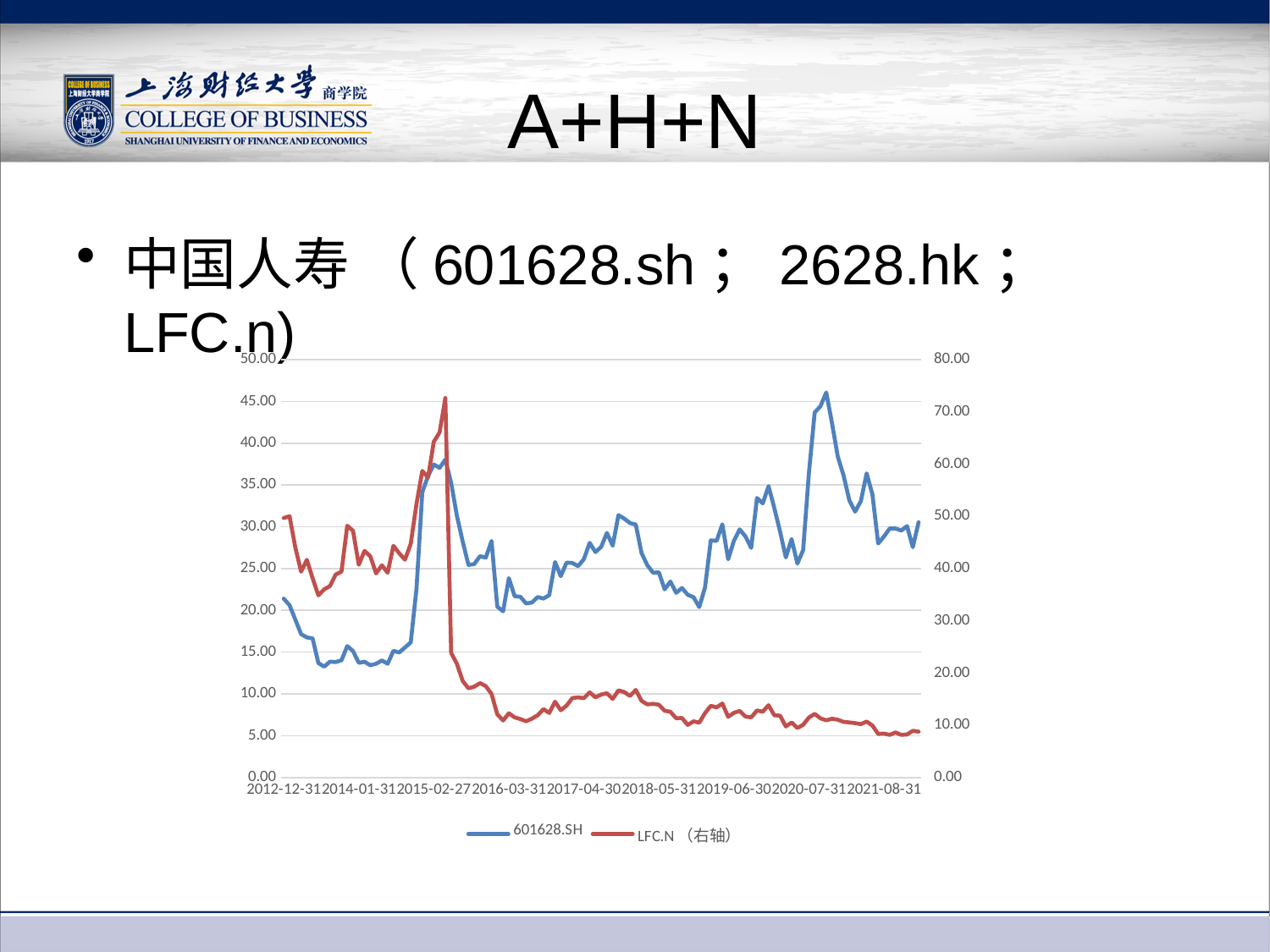
How many series does the chart's legend list? 2 Is the value of LFC.N at 2021-08-31 greater or less than 10 on the right axis? less Which series is plotted on the right axis according to the legend? LFC.N Does the 601628.SH series rise or fall from 2012-12-31 to 2014-01-31? fall Is the peak value of LFC.N around 2015 greater or less than 60 on the right axis? greater Does the LFC.N series rise or fall overall from 2016-03-31 to 2021-08-31? fall How many date labels are shown along the x axis? 9 Is the peak value of 601628.SH around 2020-07-31 greater or less than 40 on the left axis? greater What is the maximum value shown on the left vertical axis? 50.00 What kind of chart is shown on the slide? line chart What is the maximum value shown on the right vertical axis? 80.00